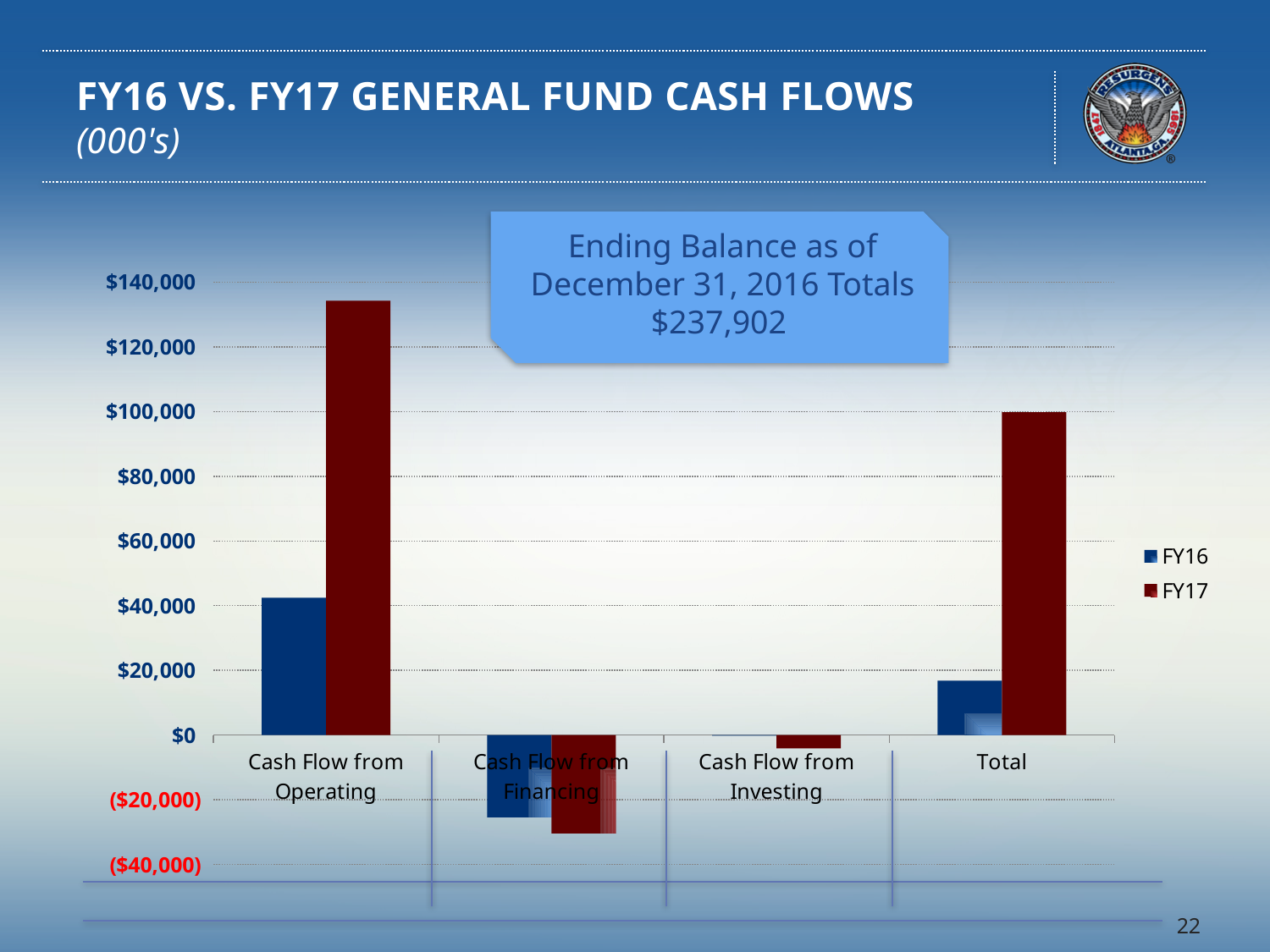
Is the FY16 value for Cash Flow from Financing greater or less than $0? less What kind of chart is shown on the slide? Bar chart Is the FY16 value for Cash Flow from Operating greater or less than $60,000? less What ending balance total is stated in the callout box on the chart? $237,902 For Cash Flow from Operating, which is larger, FY16 or FY17? FY17 How many series does the legend list? 2 Which category has the highest FY17 value? Cash Flow from Operating Is the FY17 value for Cash Flow from Operating greater or less than $120,000? greater How many categories are shown on the x axis? 4 Which colour represents FY17 in the legend? Dark red Which category has the lowest FY17 value? Cash Flow from Financing